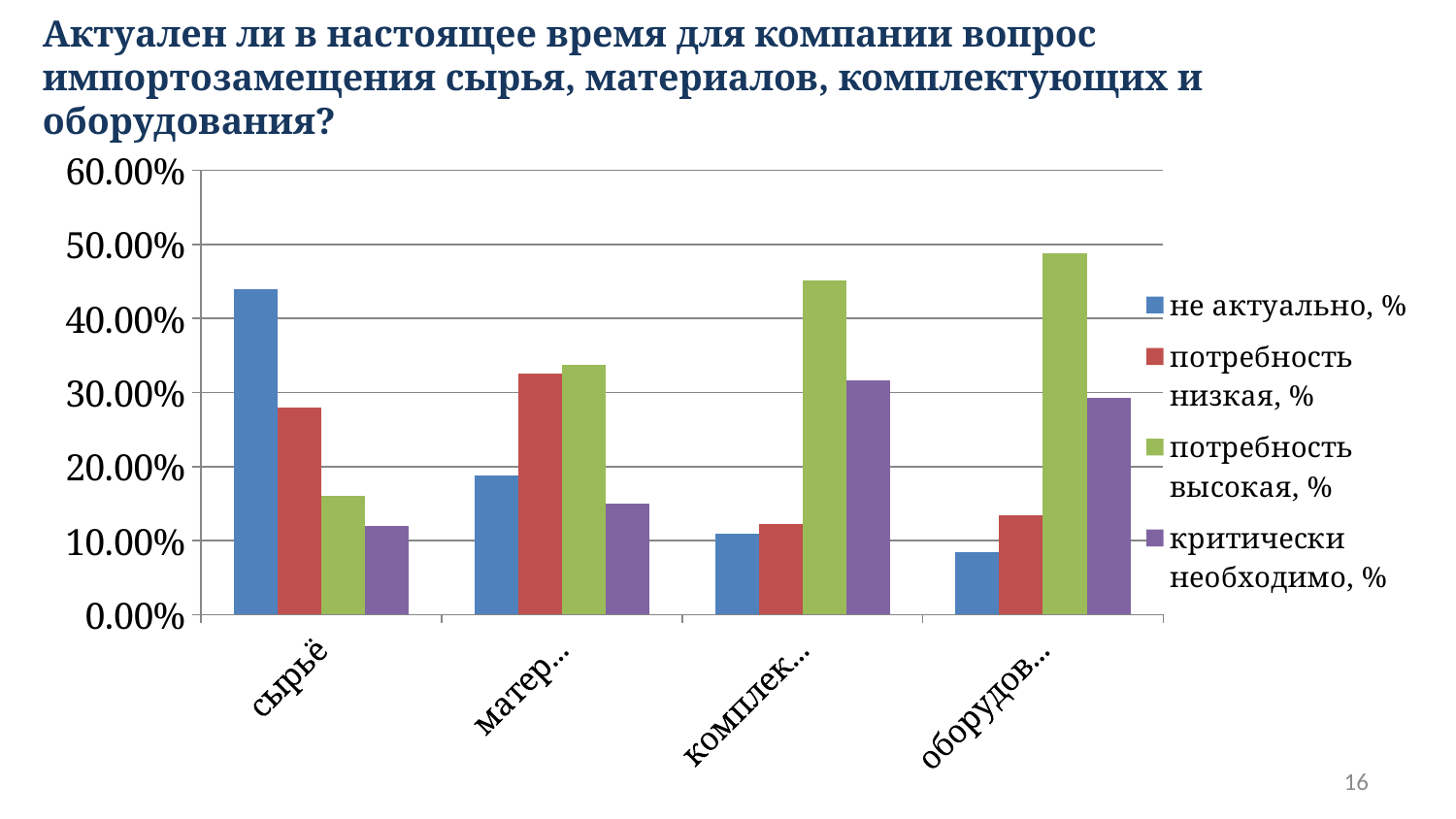
Which series has the highest value for the category сырьё? не актуально, % Does the 'не актуально, %' series rise or fall from сырьё to the last category (оборудов…)? fall Is the value of 'не актуально, %' for the last category (оборудов…) greater or less than 10.00%? less Which colour represents the series 'потребность высокая, %' in the legend? green For сырьё, which is larger: 'не актуально, %' or 'потребность низкая, %'? не актуально, % Which series has the lowest value for the category сырьё? критически необходимо, % How many series does the legend list? 4 What kind of chart is shown on the slide? bar chart How many categories are shown on the x axis? 4 Does the 'потребность высокая, %' series rise or fall from сырьё to the last category (оборудов…)? rise Is the value of 'потребность высокая, %' for сырьё greater or less than 20.00%? less Is the value of 'не актуально, %' for сырьё greater or less than 40.00%? greater